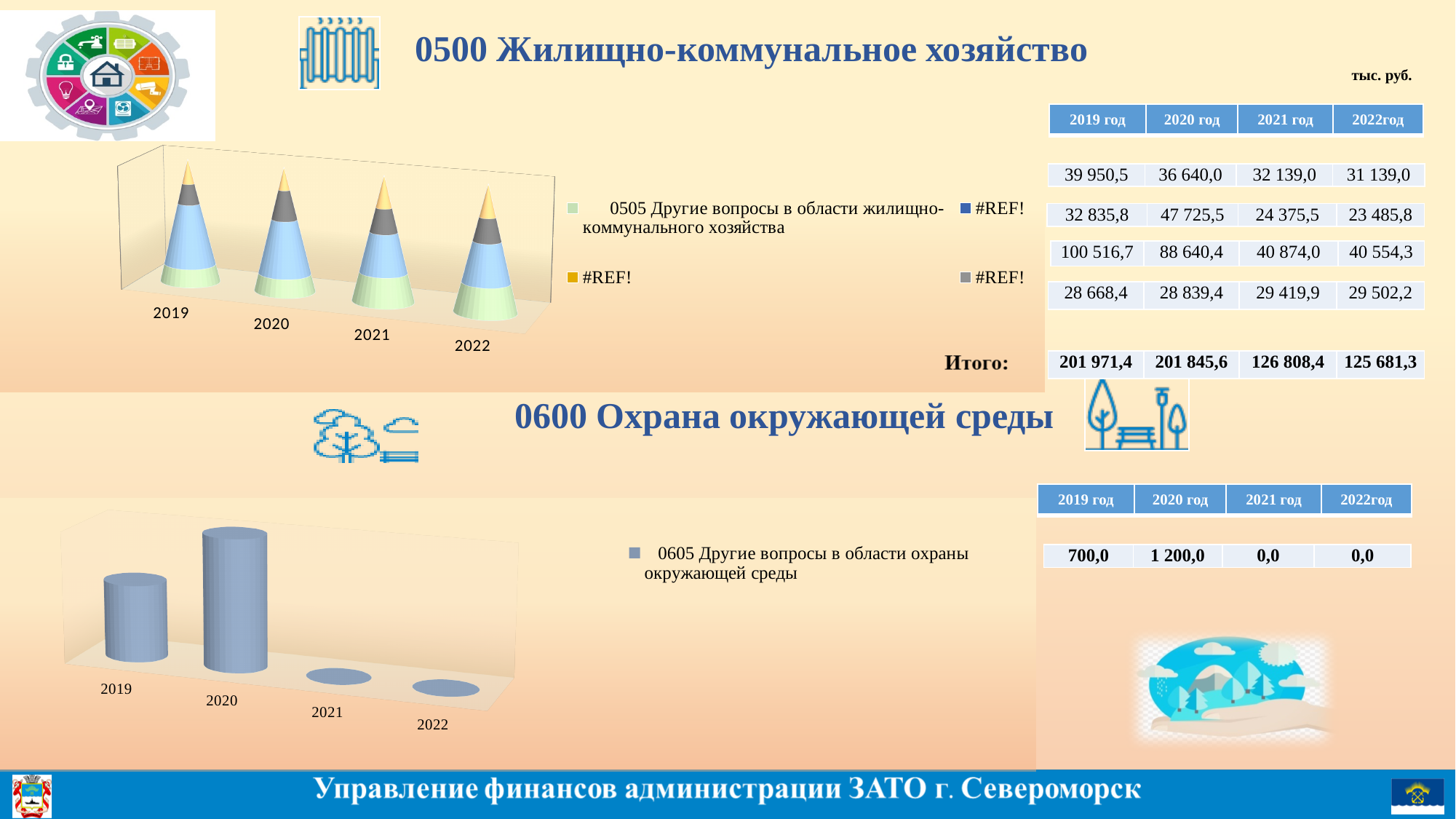
How many series does the legend of the bottom chart (0600 Охрана окружающей среды) list? 1 What kind of chart is the bottom chart (0600 Охрана окружающей среды)? bar chart In the bottom chart (0600 Охрана окружающей среды), by how much does the 2020 value exceed the 2019 value? 500,0 In the bottom chart (0600 Охрана окружающей среды), what is the value for 2020 according to the table? 1 200,0 In the top chart (0500 Жилищно-коммунальное хозяйство), which year has the lowest total (Итого) according to the table? 2022 How many years are shown on the x axis of the top chart (0500 Жилищно-коммунальное хозяйство)? 4 How many series does the legend of the top chart (0500 Жилищно-коммунальное хозяйство) list? 4 In the bottom chart (0600 Охрана окружающей среды), what is the value for 2019 according to the table? 700,0 In the bottom chart (0600 Охрана окружающей среды), do the values rise or fall from 2020 to 2022? fall In the top chart (0500 Жилищно-коммунальное хозяйство), what is the total (Итого) for 2019 according to the table? 201 971,4 How many years are shown on the x axis of the bottom chart (0600 Охрана окружающей среды)? 4 In the bottom chart (0600 Охрана окружающей среды), which year has the highest value? 2020